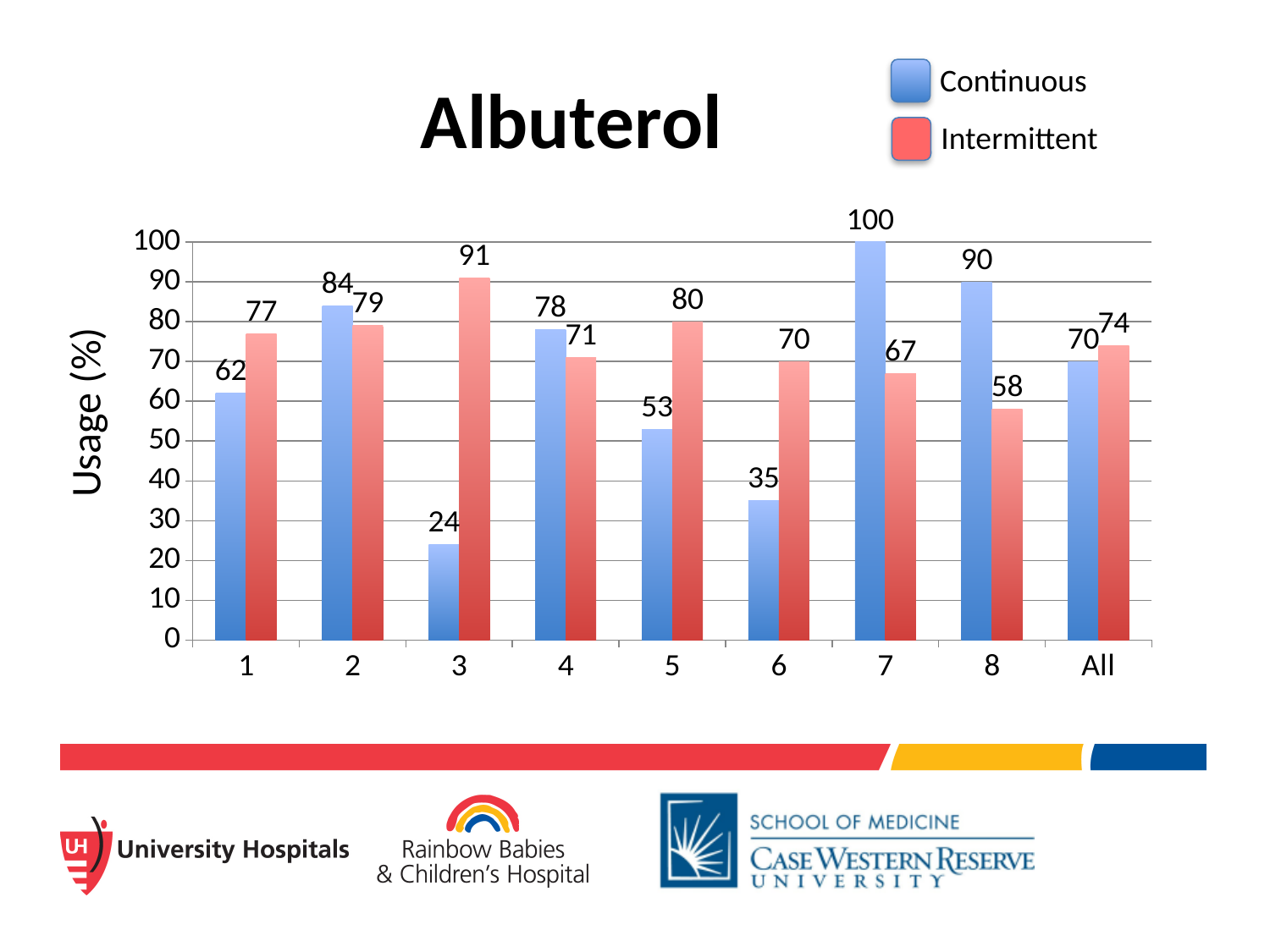
Which is larger for category 8, the Continuous value or the Intermittent value? Continuous What is the Continuous usage value for the 'All' category? 70 What is the difference between the Intermittent and Continuous values for category 3? 67 What is the Continuous usage value for category 3? 24 Is the Continuous value for category 6 greater or less than 40? less Which category has the highest Continuous usage value? 7 What kind of chart is shown on the slide? bar chart How many categories are shown on the x axis? 9 Which category has the lowest Intermittent usage value? 8 What is the title of the chart? Albuterol What is the Intermittent usage value for category 7? 67 How many series does the legend list? 2